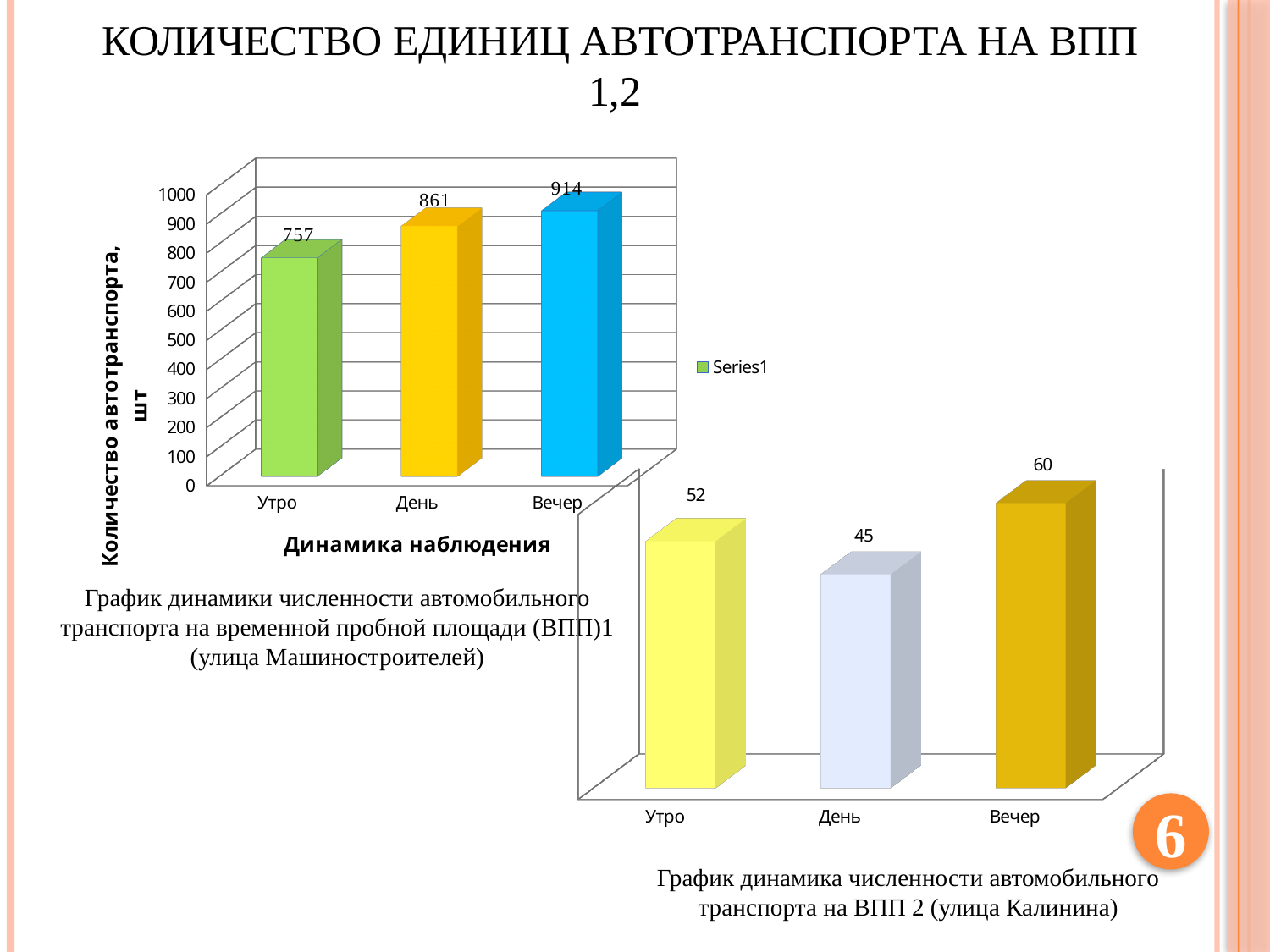
In the top-left chart (ВПП 1), which category has the highest value? Вечер In the top-left chart (ВПП 1), what is the difference between the values for Вечер and Утро? 157 In the top-left chart (ВПП 1), what is the value for Утро? 757 In the bottom-right chart (ВПП 2), what is the value for День? 45 In the top-left chart (ВПП 1), do the values rise or fall from Утро to Вечер? rise In the bottom-right chart (ВПП 2), what is the difference between the values for Вечер and День? 15 In the bottom-right chart (ВПП 2), which is larger, the value for Утро or the value for Вечер? Вечер In the bottom-right chart (ВПП 2), which category has the lowest value? День What kind of chart is the top-left chart (ВПП 1)? bar chart In the top-left chart (ВПП 1), what is the value for Вечер? 914 In the top-left chart (ВПП 1), how many series does the legend list? 1 How many categories are shown in the bottom-right chart (ВПП 2)? 3